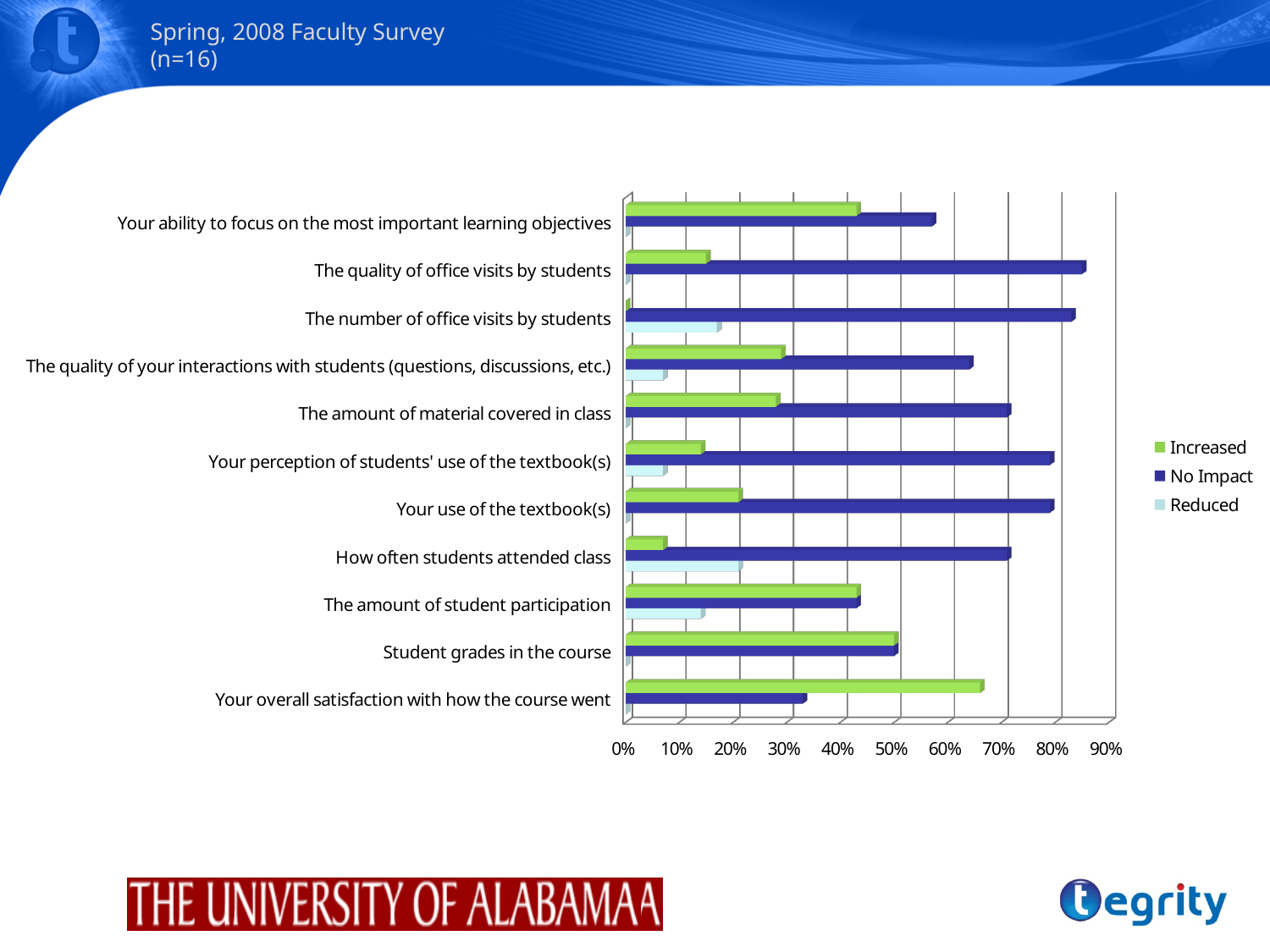
Which has the larger 'Increased' value: 'Your ability to focus on the most important learning objectives' or 'The quality of office visits by students'? Your ability to focus on the most important learning objectives What are the three entries listed in the chart legend? Increased, No Impact, Reduced Is the 'Reduced' value for 'How often students attended class' greater or less than 30%? less Which category has the highest 'Increased' value? Your overall satisfaction with how the course went Is the 'No Impact' value for 'The quality of office visits by students' greater or less than 80%? greater For 'Your overall satisfaction with how the course went', which is larger: the 'Increased' value or the 'No Impact' value? Increased How many series does the legend list? 3 What kind of chart is shown on the slide? bar chart Which category has the highest 'Reduced' value? How often students attended class How many categories are plotted on the chart? 11 Which category has the lowest 'Increased' value? The number of office visits by students Is the 'Increased' value for 'Your overall satisfaction with how the course went' greater or less than 60%? greater